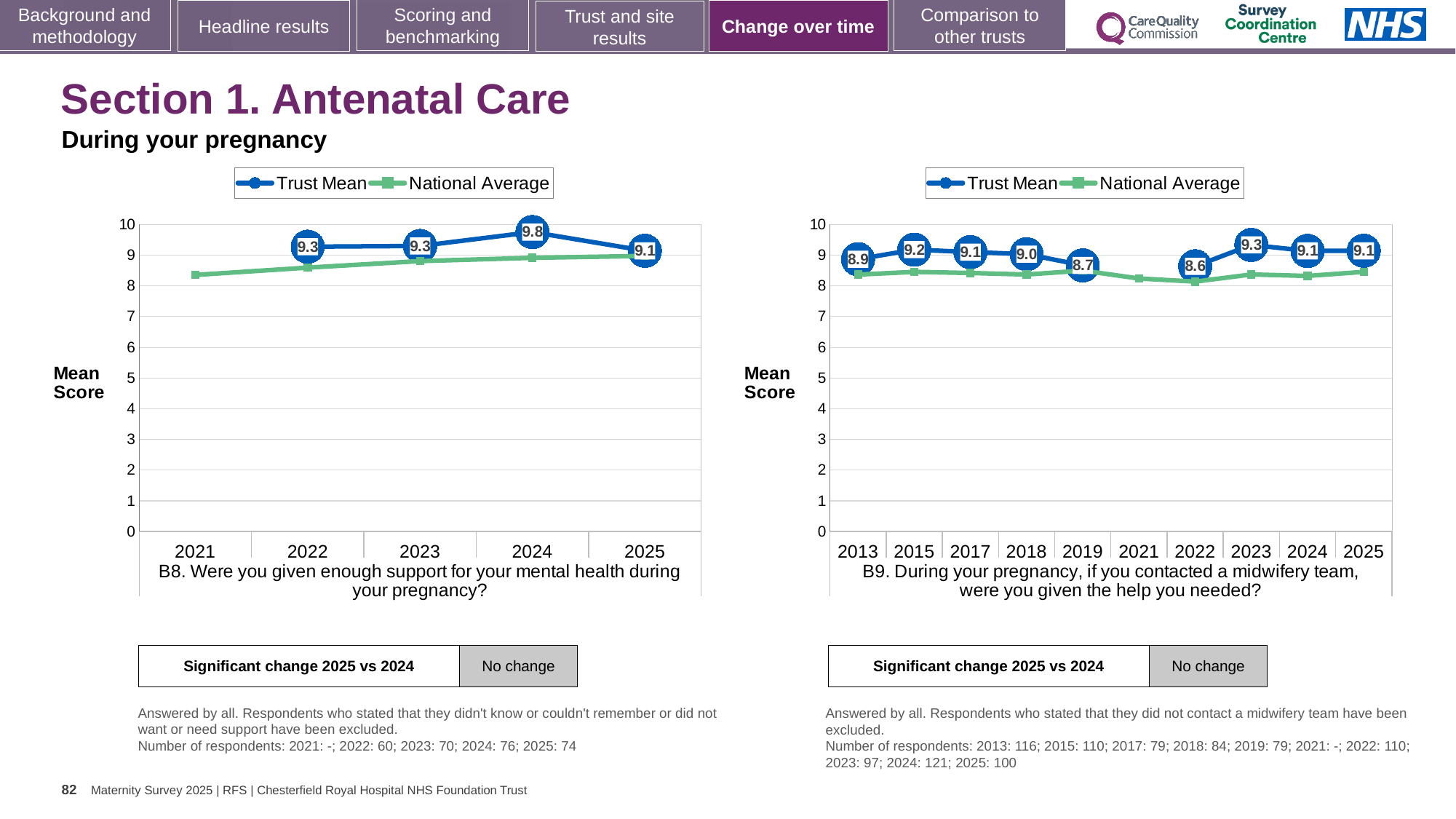
In the B9 chart (right), is the Trust Mean higher in 2015 or in 2022? 2015 In the B8 chart (left), how many series does the legend list? 2 In the B9 chart (right), which year has the highest Trust Mean? 2023 What type of chart is the B9 chart (right)? Line chart In the B8 chart (left), what is the difference between the Trust Mean in 2024 and in 2025? 0.7 In the B8 chart (left), what is the Trust Mean for 2025? 9.1 In the B9 chart (right), how many years are shown on the x axis? 10 In the B9 chart (right), what is the Trust Mean for 2019? 8.7 In the B8 chart (left), which year has the highest Trust Mean? 2024 In the B8 chart (left), what is the Trust Mean for 2024? 9.8 In the B9 chart (right), is the National Average for 2025 greater or less than 8? greater In the B9 chart (right), which year has the lowest Trust Mean? 2022